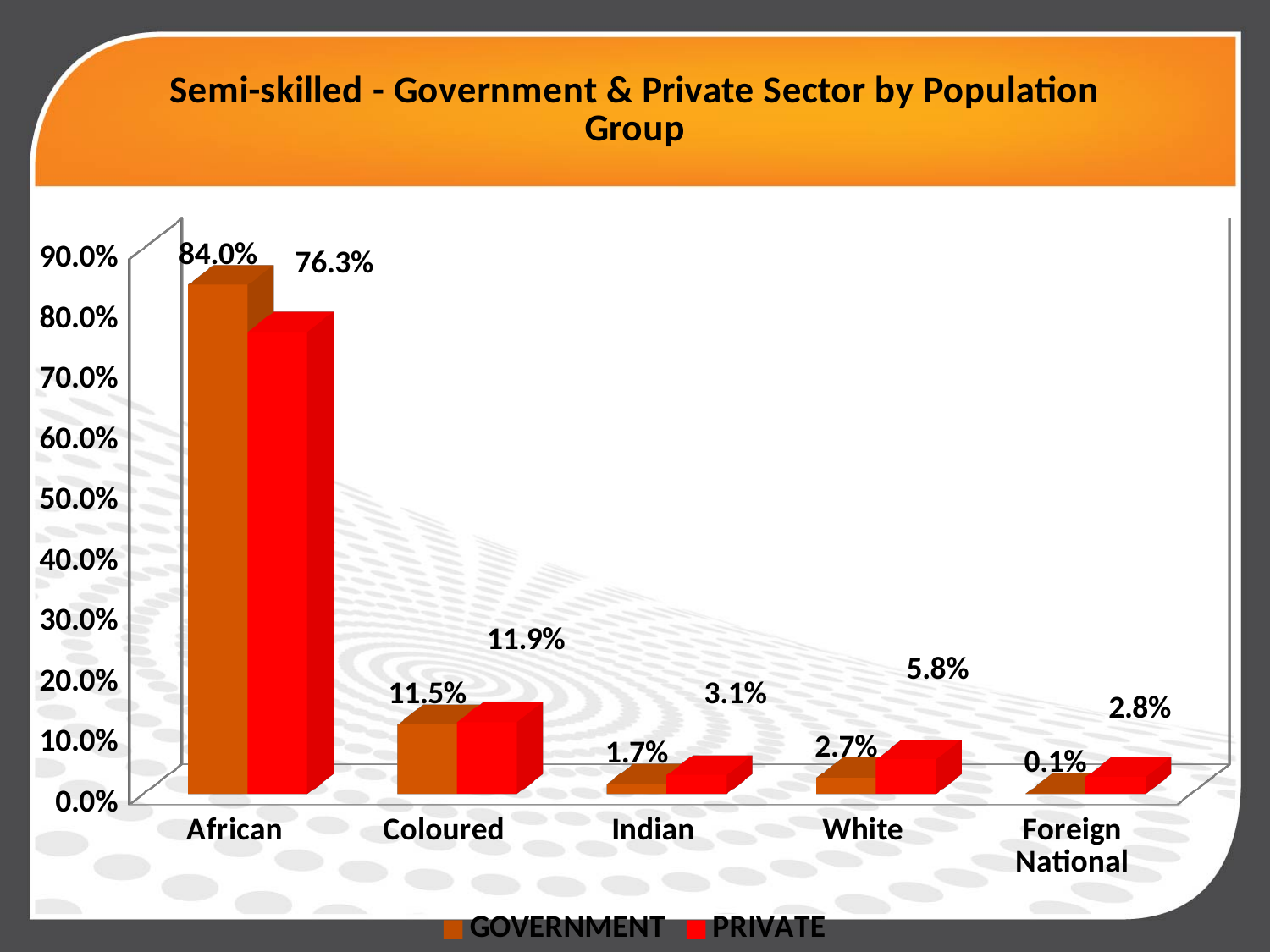
What is the title of the chart? Semi-skilled - Government & Private Sector by Population Group How many population groups are shown on the x axis? 5 Which population group has the highest PRIVATE value? African What is the GOVERNMENT value for Foreign National? 0.1% What is the PRIVATE value for White? 5.8% How many series does the legend list? 2 Which population group has the lowest GOVERNMENT value? Foreign National Which is larger for Indian, the GOVERNMENT value or the PRIVATE value? PRIVATE What is the GOVERNMENT value for African? 84.0% What kind of chart is shown on the slide? Bar chart What is the difference between the GOVERNMENT and PRIVATE values for African? 7.7% What is the PRIVATE value for Coloured? 11.9%